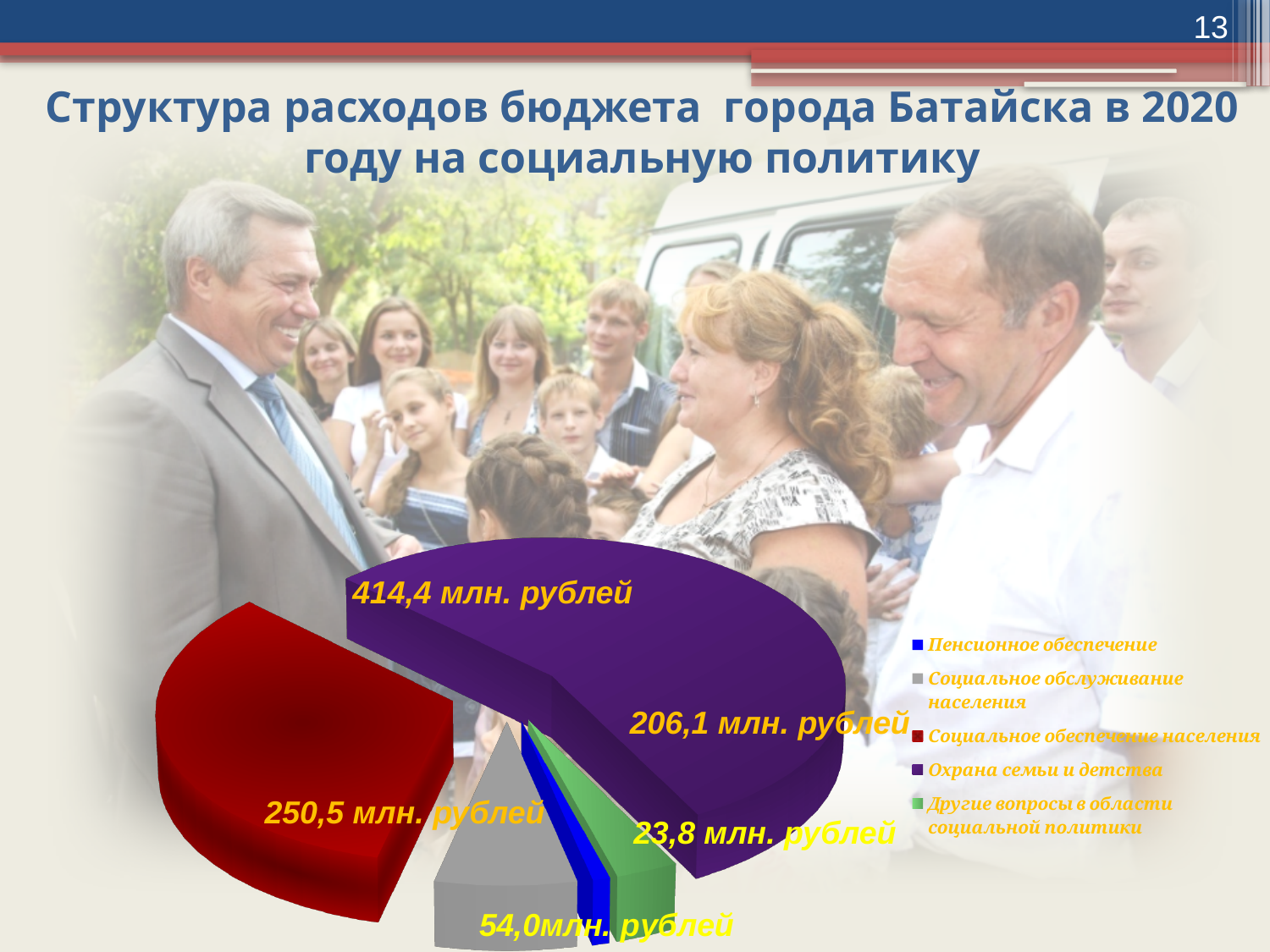
Which category has the largest slice of the pie? Охрана семьи и детства Which category has the smallest slice of the pie? Пенсионное обеспечение Which slice is larger: Социальное обеспечение населения (red) or Социальное обслуживание населения (grey)? Социальное обеспечение населения What is the difference between the largest labelled value (414,4 млн. рублей) and the red slice value (250,5 млн. рублей)? 163,9 млн. рублей Is the value of the red slice (Социальное обеспечение населения) greater or less than 200 млн. рублей? greater What is the largest value labelled on the pie chart? 414,4 млн. рублей What is the title of the chart slide? Структура расходов бюджета города Батайска в 2020 году на социальную политику What is the smallest value labelled on the pie chart? 23,8 млн. рублей What kind of chart is shown on the slide? pie chart What value is labelled on the red slice (Социальное обеспечение населения)? 250,5 млн. рублей How many categories does the legend of the pie chart list? 5 What colour represents Охрана семьи и детства in the legend? purple